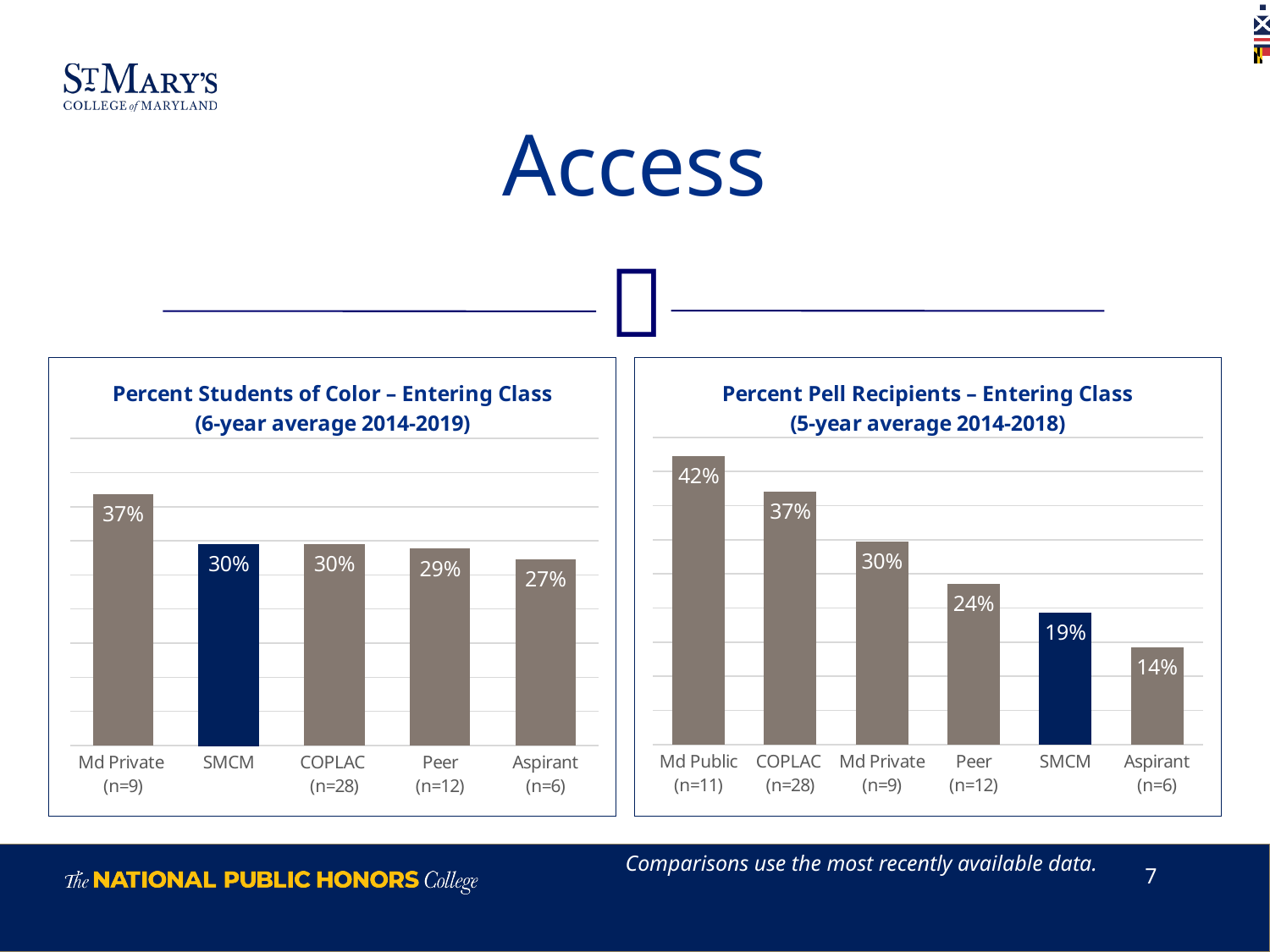
How many categories are shown in the 'Percent Students of Color – Entering Class' chart? 5 In the 'Percent Students of Color – Entering Class' chart, what is the value for SMCM? 30% How many categories are shown in the 'Percent Pell Recipients – Entering Class' chart? 6 In the 'Percent Pell Recipients – Entering Class' chart, which category has the lowest value? Aspirant (n=6) In the 'Percent Pell Recipients – Entering Class' chart, which is larger, Peer (n=12) or SMCM? Peer (n=12) In the 'Percent Pell Recipients – Entering Class' chart, what is the difference between Md Public and SMCM? 23% In the 'Percent Students of Color – Entering Class' chart, which category has the lowest value? Aspirant (n=6) What kind of chart is the 'Percent Pell Recipients – Entering Class' chart? Bar chart In the 'Percent Pell Recipients – Entering Class' chart, what is the value for Md Public (n=11)? 42% In the 'Percent Students of Color – Entering Class' chart, which category has the highest value? Md Private (n=9) In the 'Percent Pell Recipients – Entering Class' chart, what is the value for SMCM? 19% In the 'Percent Students of Color – Entering Class' chart, what is the difference between Md Private and Aspirant? 10%